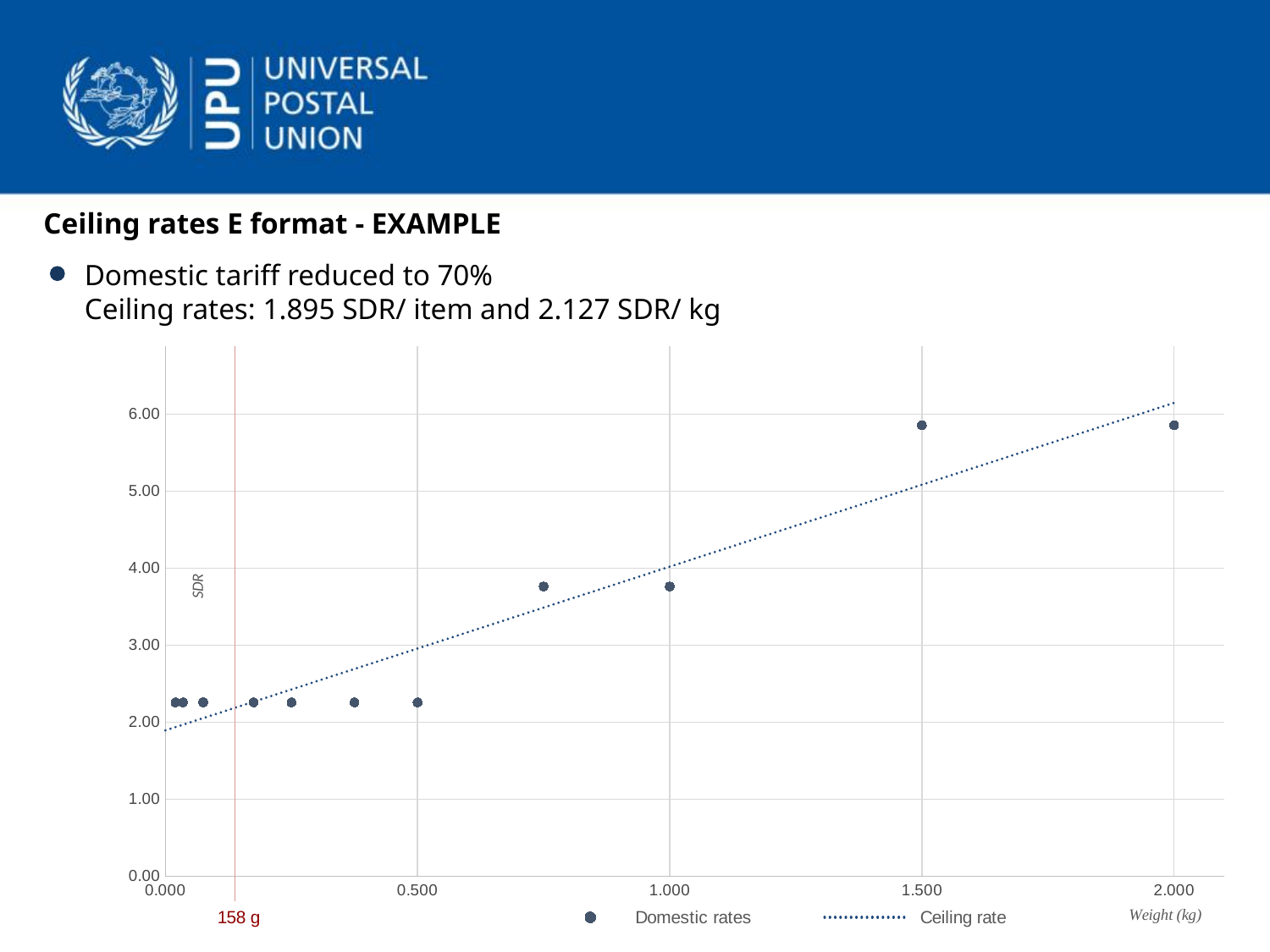
Is the Domestic rates value at 2.000 kg greater or less than 6.00? less Is the Domestic rates value at 0.500 kg greater or less than 2.00? greater Is the Domestic rates value at 0.500 kg greater or less than 3.00? less What are the two series named in the chart legend? Domestic rates and Ceiling rate Which is larger, the Domestic rates value at 1.500 kg or at 0.500 kg? 1.500 kg How many series does the chart legend list? 2 What is the label of the x axis of the chart? Weight (kg) Does the Ceiling rate line rise or fall as weight increases along the x axis? rise What kind of chart is shown on the slide? scatter chart Do the Domestic rates values rise or fall as weight increases along the x axis? rise